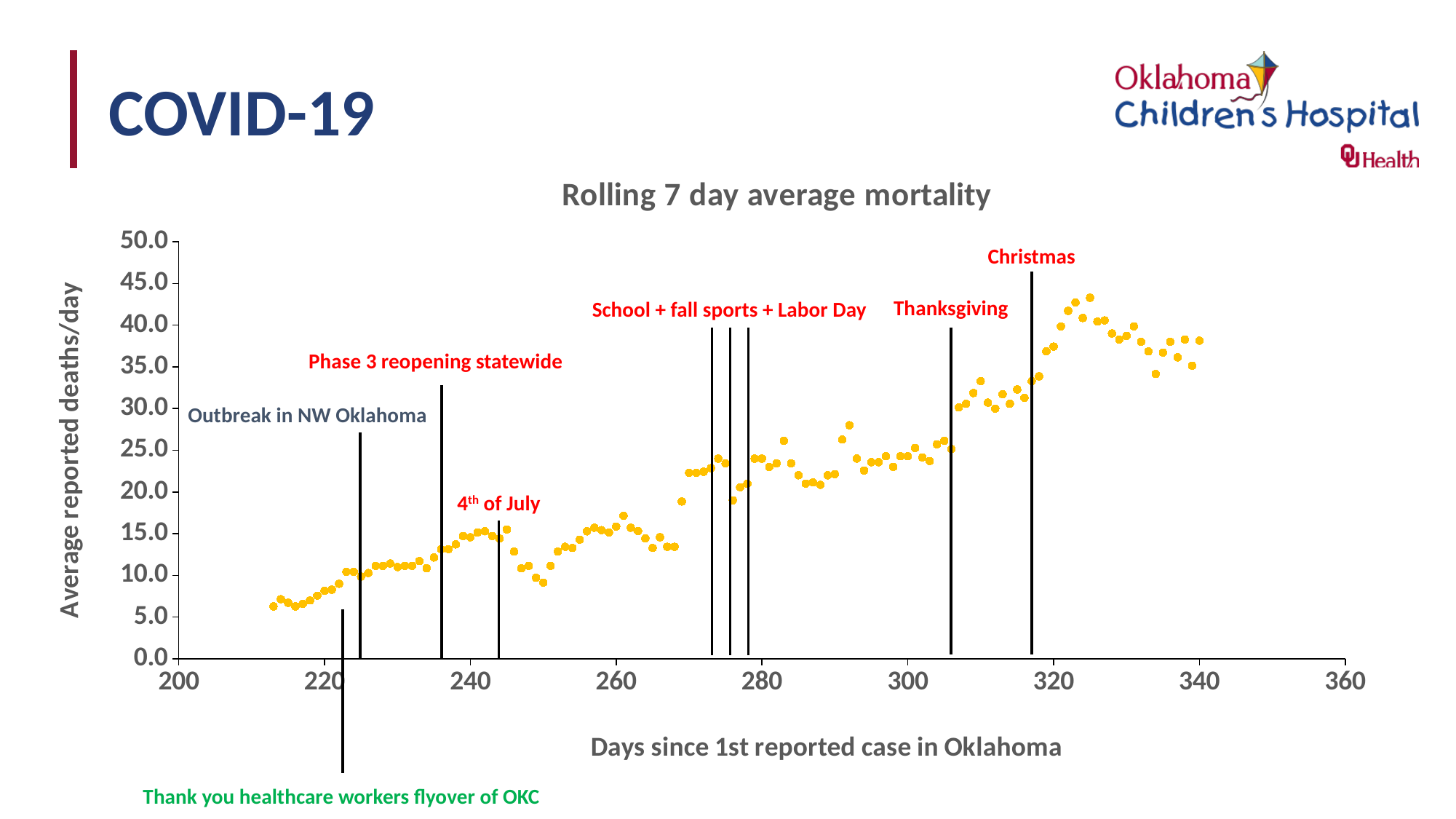
Which is larger, the value at day 260 or the value at day 250? day 260 Is the value at day 250 greater or less than 10? less Is the highest plotted value greater or less than 40? greater What is the title of the chart? Rolling 7 day average mortality Is the value at day 280 greater or less than 20? greater Which event is marked by the vertical line at about day 317? Christmas Which is larger, the value at day 213 or the value at day 325? day 325 Overall, do the plotted values rise or fall as the days since the 1st reported case increase? rise What kind of chart is shown on the slide? scatter chart